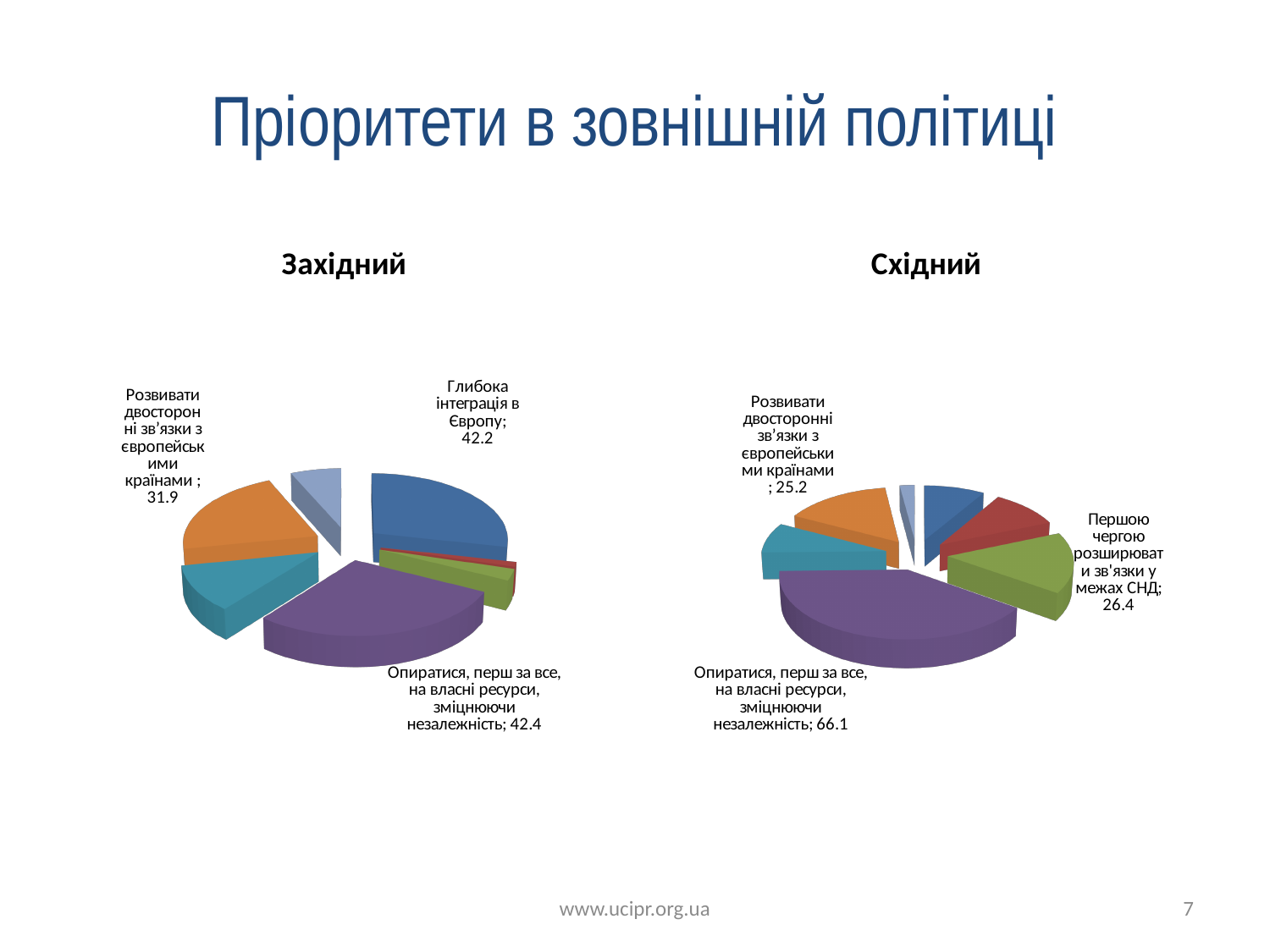
In the Східний chart, which labelled category has the lowest value? Розвивати двосторонні зв'язки з європейськими країнами In the Східний chart, what value is shown for "Першою чергою розширювати зв'язки у межах СНД"? 26.4 In the Східний chart, what value is shown for "Опиратися, перш за все, на власні ресурси, зміцнюючи незалежність"? 66.1 In the Західний chart, what value is shown for "Опиратися, перш за все, на власні ресурси, зміцнюючи незалежність"? 42.4 In the Західний chart, what value is shown for "Глибока інтеграція в Європу"? 42.2 In the Східний chart, what is the difference between the values for "Опиратися, перш за все, на власні ресурси, зміцнюючи незалежність" and "Першою чергою розширювати зв'язки у межах СНД"? 39.7 In the Західний chart, what is the difference between the values for "Глибока інтеграція в Європу" and "Розвивати двосторонні зв'язки з європейськими країнами"? 10.3 In the Східний chart, which labelled category has the highest value? Опиратися, перш за все, на власні ресурси, зміцнюючи незалежність Which chart shows a larger value for "Опиратися, перш за все, на власні ресурси, зміцнюючи незалежність", Західний or Східний? Східний What type of chart is used for the Західний data? Pie chart In the Західний chart, what value is shown for "Розвивати двосторонні зв'язки з європейськими країнами"? 31.9 In the Східний chart, what value is shown for "Розвивати двосторонні зв'язки з європейськими країнами"? 25.2